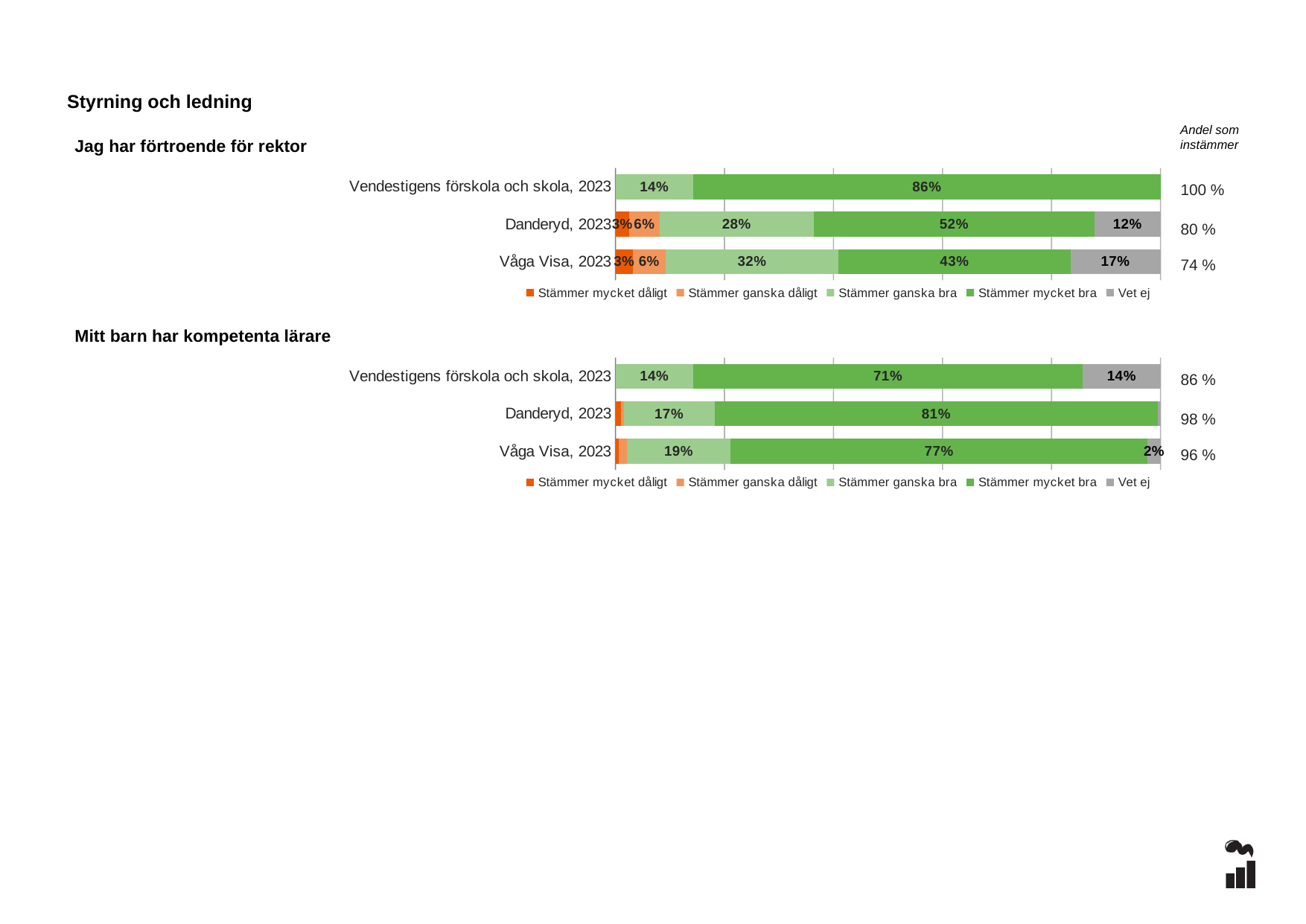
In the chart 'Mitt barn har kompetenta lärare', what is the 'Vet ej' value for Vendestigens förskola och skola, 2023? 14% In the chart 'Mitt barn har kompetenta lärare', is the 'Stämmer ganska bra' value larger for Danderyd, 2023 or Våga Visa, 2023? Våga Visa, 2023 In the chart 'Jag har förtroende för rektor', what is the 'Vet ej' value for Våga Visa, 2023? 17% How many series does the legend of the chart 'Jag har förtroende för rektor' list? 5 In the chart 'Jag har förtroende för rektor', which row has the highest 'Stämmer mycket bra' value? Vendestigens förskola och skola, 2023 In the chart 'Jag har förtroende för rektor', what is the 'Stämmer ganska bra' value for Danderyd, 2023? 28% In the chart 'Jag har förtroende för rektor', what is the 'Stämmer mycket bra' value for Vendestigens förskola och skola, 2023? 86% In the chart 'Mitt barn har kompetenta lärare', which row has the lowest 'Stämmer mycket bra' value? Vendestigens förskola och skola, 2023 In the chart 'Jag har förtroende för rektor', what is the difference between the 'Stämmer mycket bra' values for Danderyd, 2023 and Våga Visa, 2023? 9 percentage points In the chart 'Mitt barn har kompetenta lärare', what is the 'Stämmer mycket bra' value for Danderyd, 2023? 81% What kind of chart is 'Mitt barn har kompetenta lärare'? Stacked bar chart What 'Andel som instämmer' value is shown for Våga Visa, 2023 in the chart 'Jag har förtroende för rektor'? 74 %